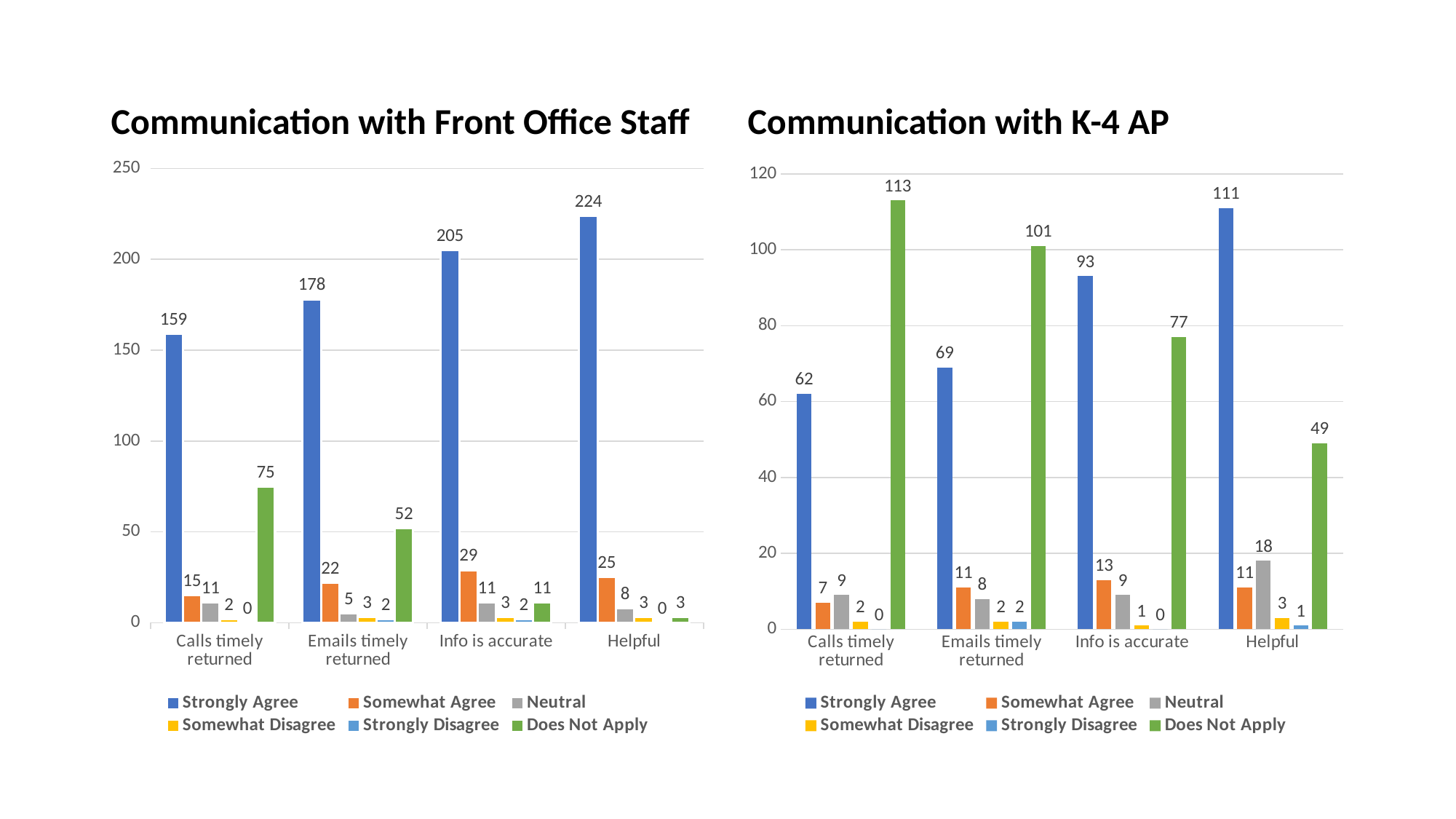
In the 'Communication with Front Office Staff' chart, what is the Strongly Agree value for Helpful? 224 In the 'Communication with K-4 AP' chart, which is larger for Emails timely returned: Strongly Agree or Does Not Apply? Does Not Apply How many categories are shown on the x axis of the 'Communication with K-4 AP' chart? 4 In the 'Communication with K-4 AP' chart, do the Strongly Agree values rise or fall from Calls timely returned to Helpful? Rise In the 'Communication with Front Office Staff' chart, what is the Neutral value for Info is accurate? 11 In the 'Communication with Front Office Staff' chart, is the Strongly Agree value for Emails timely returned greater or less than 150? greater In the 'Communication with K-4 AP' chart, what is the Does Not Apply value for Calls timely returned? 113 In the 'Communication with Front Office Staff' chart, what is the difference between the Strongly Agree values for Info is accurate and Calls timely returned? 46 In the 'Communication with Front Office Staff' chart, which category has the highest Strongly Agree value? Helpful What kind of chart is 'Communication with K-4 AP'? Bar chart How many series does the legend of the 'Communication with Front Office Staff' chart list? 6 In the 'Communication with K-4 AP' chart, which category has the lowest Does Not Apply value? Helpful